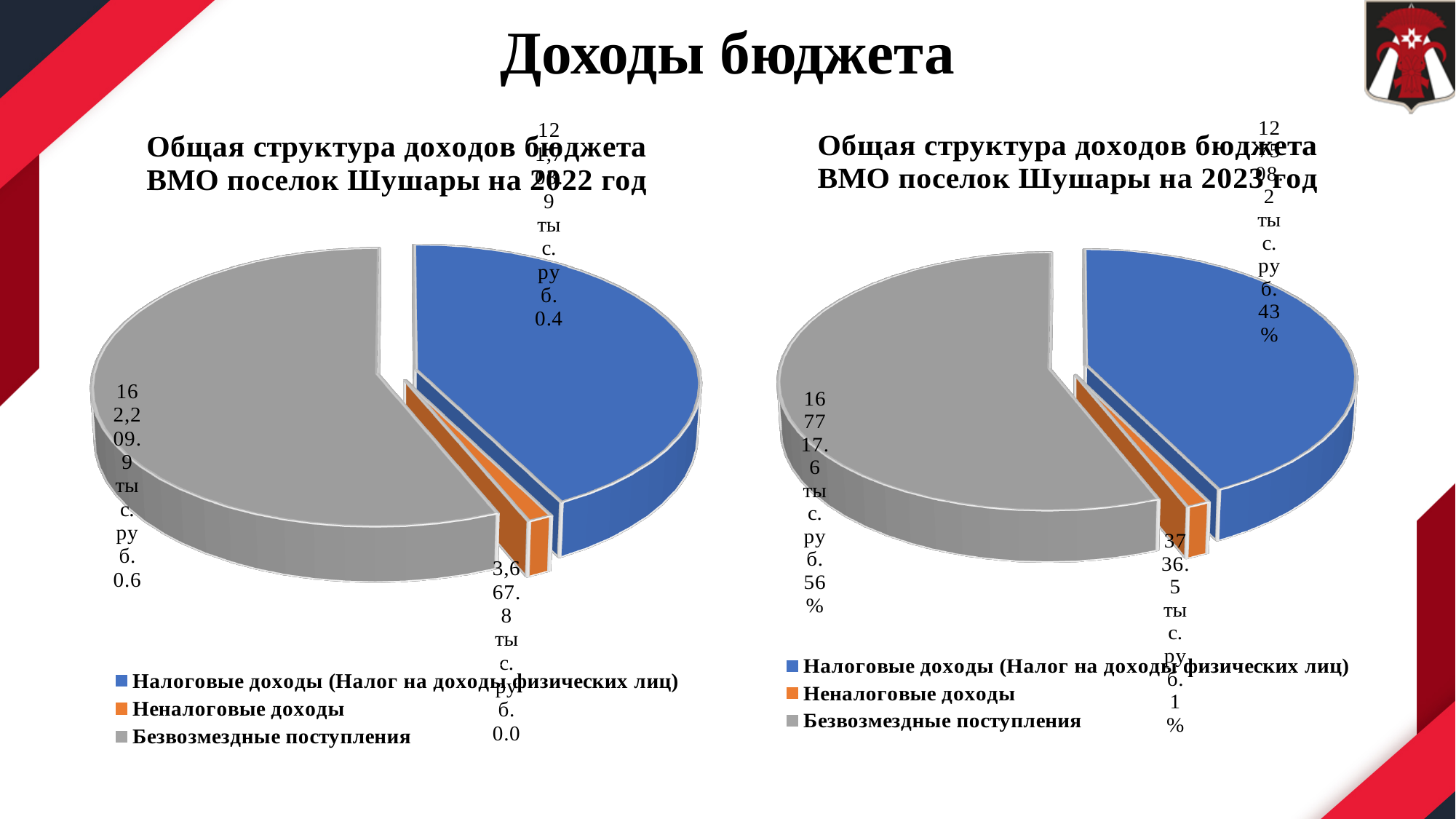
In the 2023 chart on the right, which is larger: Налоговые доходы or Неналоговые доходы? Налоговые доходы In the 2023 chart on the right, what share of the pie is Неналоговые доходы? 1% How many entries does the legend of the 2022 chart on the left list? 3 In the 2023 chart on the right, which category has the largest slice? Безвозмездные поступления In the 2023 chart on the right, what share of the pie is Безвозмездные поступления? 56% What kind of chart is used for the 2022 budget income structure on the left? Pie chart How many slices does the pie chart for 2023 on the right have? 3 What colour represents Безвозмездные поступления in both pie charts? Grey In the 2023 chart on the right, what share of the pie is Налоговые доходы (Налог на доходы физических лиц)? 43% In the 2023 chart on the right, what is the value labelled for Неналоговые доходы? 3736.5 тыс. руб. In the 2022 chart on the left, which category has the smallest slice? Неналоговые доходы In the 2022 chart on the left, which is larger: Безвозмездные поступления or Налоговые доходы? Безвозмездные поступления